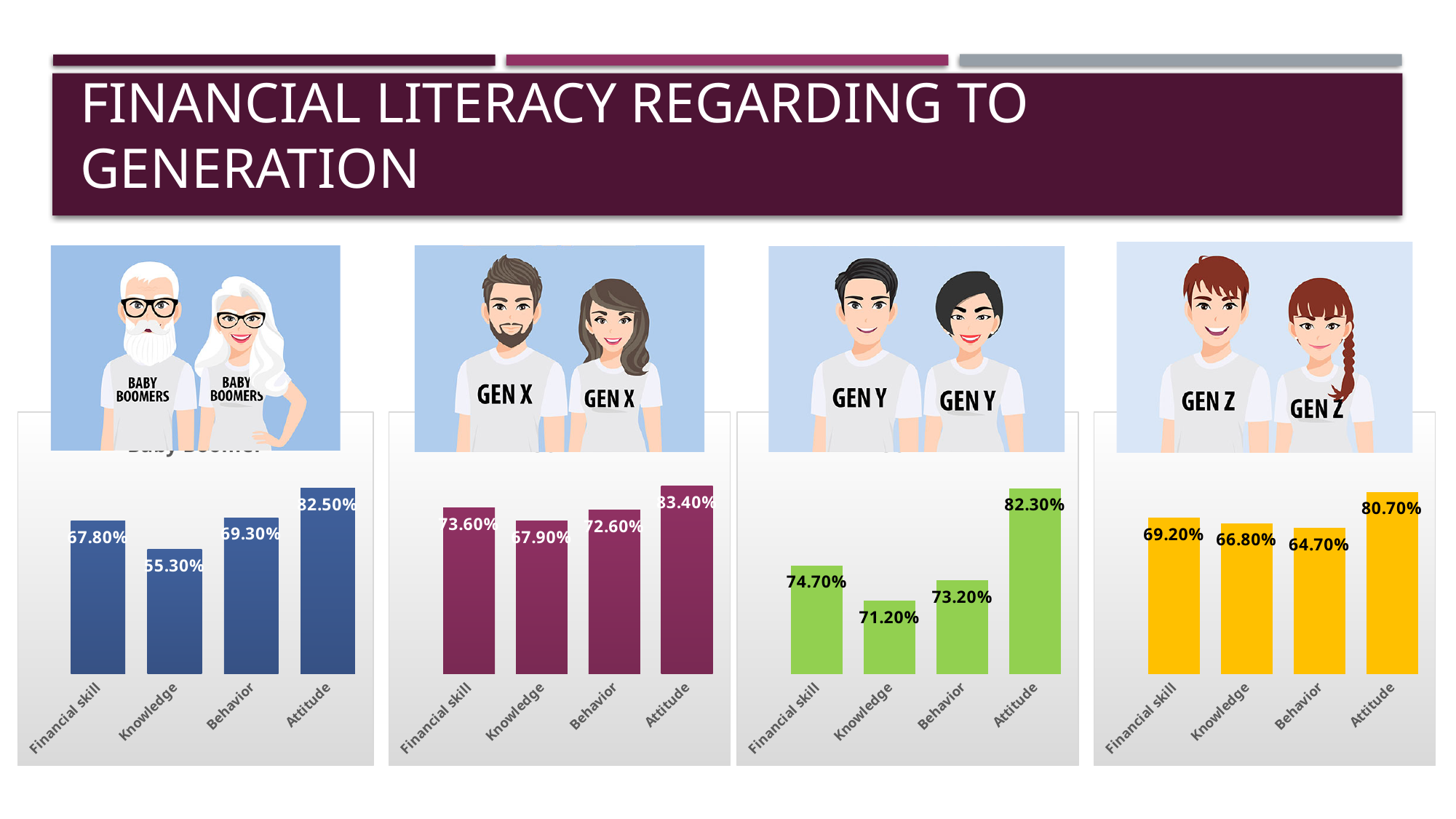
In the third chart from the left (Gen Y), which is larger, the value for Financial skill or the value for Behavior? Financial skill How many charts are shown on the slide? 4 In the second chart from the left (Gen X), what is the difference between the Attitude and Knowledge values? 15.50% In the rightmost chart (Gen Z), what is the value for Behavior? 64.70% In the leftmost chart (Baby Boomers), which category has the highest value? Attitude How many categories are shown in the leftmost chart (Baby Boomers)? 4 What colour are the bars in the third chart from the left (Gen Y)? Green In the second chart from the left (Gen X), what is the value for Attitude? 83.40% In the third chart from the left (Gen Y), what is the value for Financial skill? 74.70% In the leftmost chart (Baby Boomers), what is the value for Knowledge? 55.30% In the rightmost chart (Gen Z), which category has the lowest value? Behavior What type of chart is the rightmost chart (Gen Z)? Bar chart